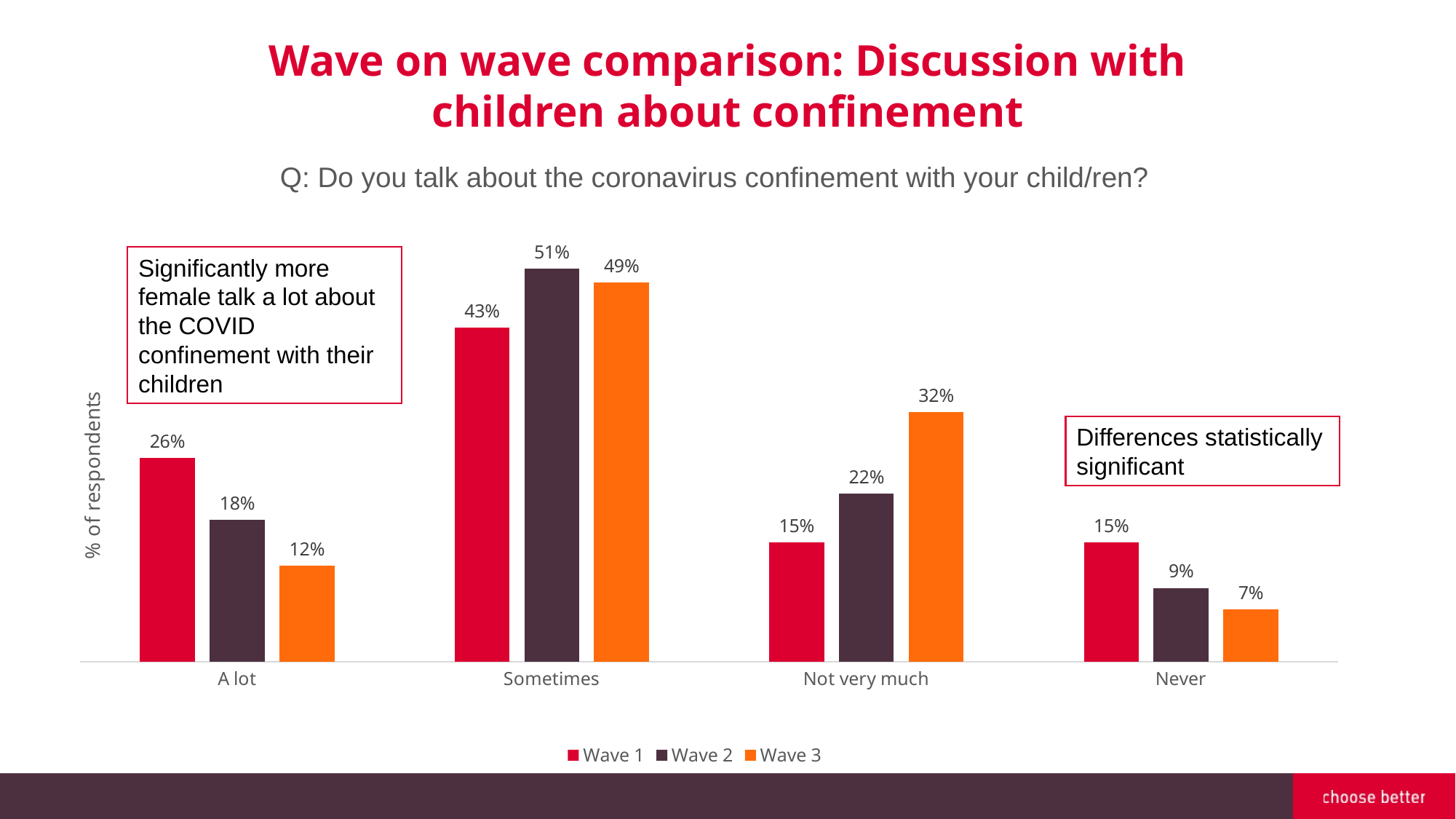
What is the difference between the Wave 3 and Wave 1 values for "Not very much"? 17% What is the Wave 3 value for "Not very much"? 32% Which category has the lowest Wave 3 value? Never How many response categories are shown on the x axis? 4 How many series does the legend list? 3 What is the Wave 1 value for "A lot"? 26% Which is larger for "A lot": the Wave 1 value or the Wave 3 value? Wave 1 What is the difference between the Wave 2 and Wave 1 values for "Sometimes"? 8% What is the label on the vertical axis? % of respondents Which category has the highest Wave 2 value? Sometimes What kind of chart is shown on the slide? Bar chart What is the Wave 2 value for "Never"? 9%